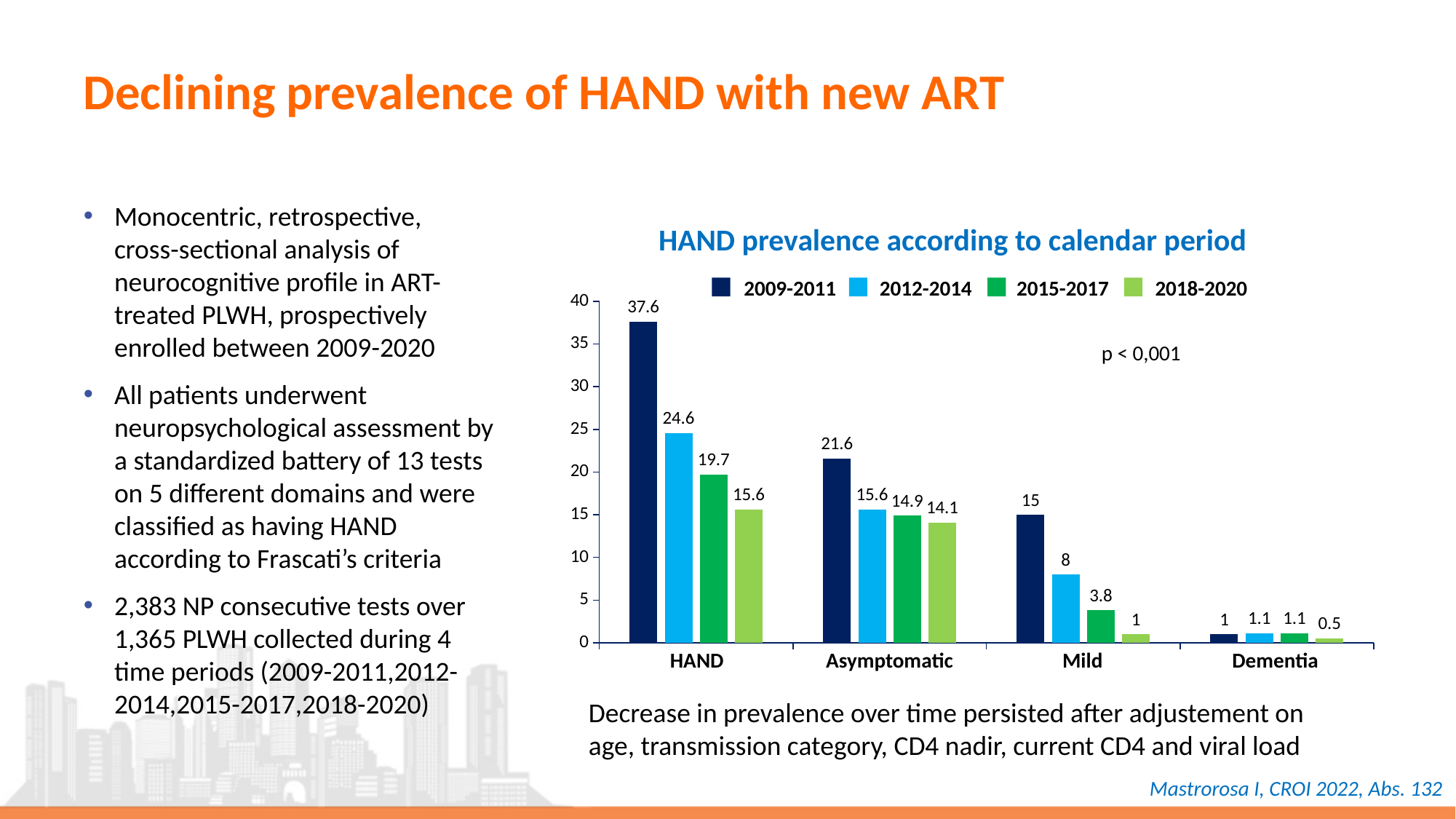
What kind of chart is shown? Bar chart Which is larger: the Mild value for 2015-2017 or the Dementia value for 2015-2017? Mild (3.8) What is the value for Asymptomatic in the 2018-2020 period? 14.1 How many series does the legend list? 4 What is the HAND prevalence for the 2009-2011 period? 37.6 How many categories are shown on the x axis? 4 Which calendar period has the highest HAND prevalence? 2009-2011 What is the difference between the HAND values for 2009-2011 and 2018-2020? 22 What is the value for Dementia in the 2018-2020 period? 0.5 What is the value for Mild in the 2012-2014 period? 8 What is the title of the chart? HAND prevalence according to calendar period Which category has the lowest value for the 2009-2011 period? Dementia